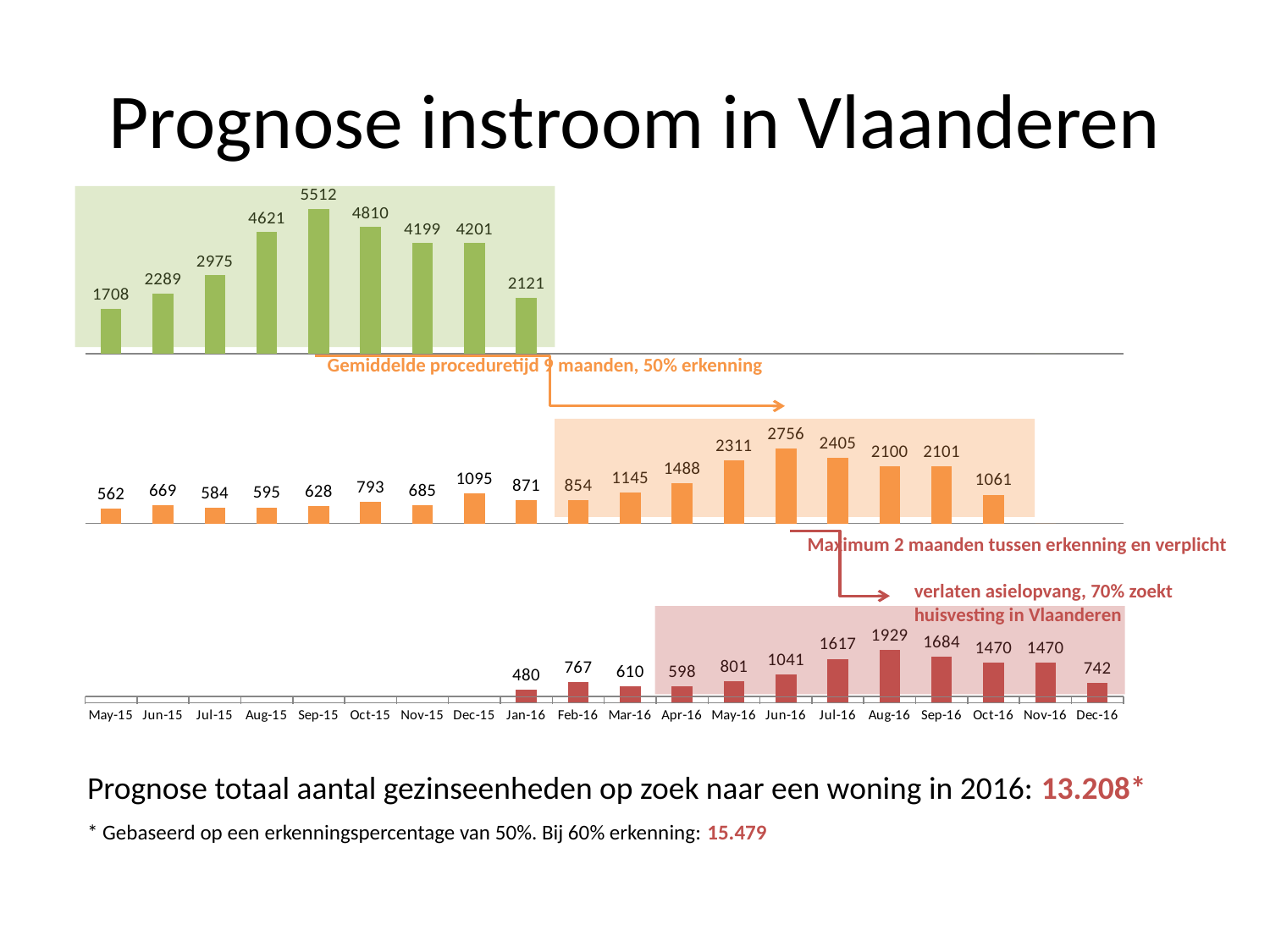
How many months are plotted in the top (green) chart? 9 In the top (green) chart, do the values rise or fall from Sep-15 to Jan-16? fall In the bottom (red) chart, what is the difference between the values for Jul-16 and Jun-16? 576 In the top (green) chart, which month has the lowest value? May-15 What kind of chart is the bottom (red) chart? bar chart In the bottom (red) chart, which month has the lowest value? Jan-16 In the middle (orange) chart, what is the value for Dec-15? 1095 In the top (green) chart, what is the difference between the values for Aug-15 and Jul-15? 1646 In the top (green) chart, what is the value for Sep-15? 5512 In the middle (orange) chart, which month has the highest value? Jun-16 In the middle (orange) chart, which is larger, the value for Apr-16 or the value for Mar-16? Apr-16 In the bottom (red) chart, what is the value for Aug-16? 1929